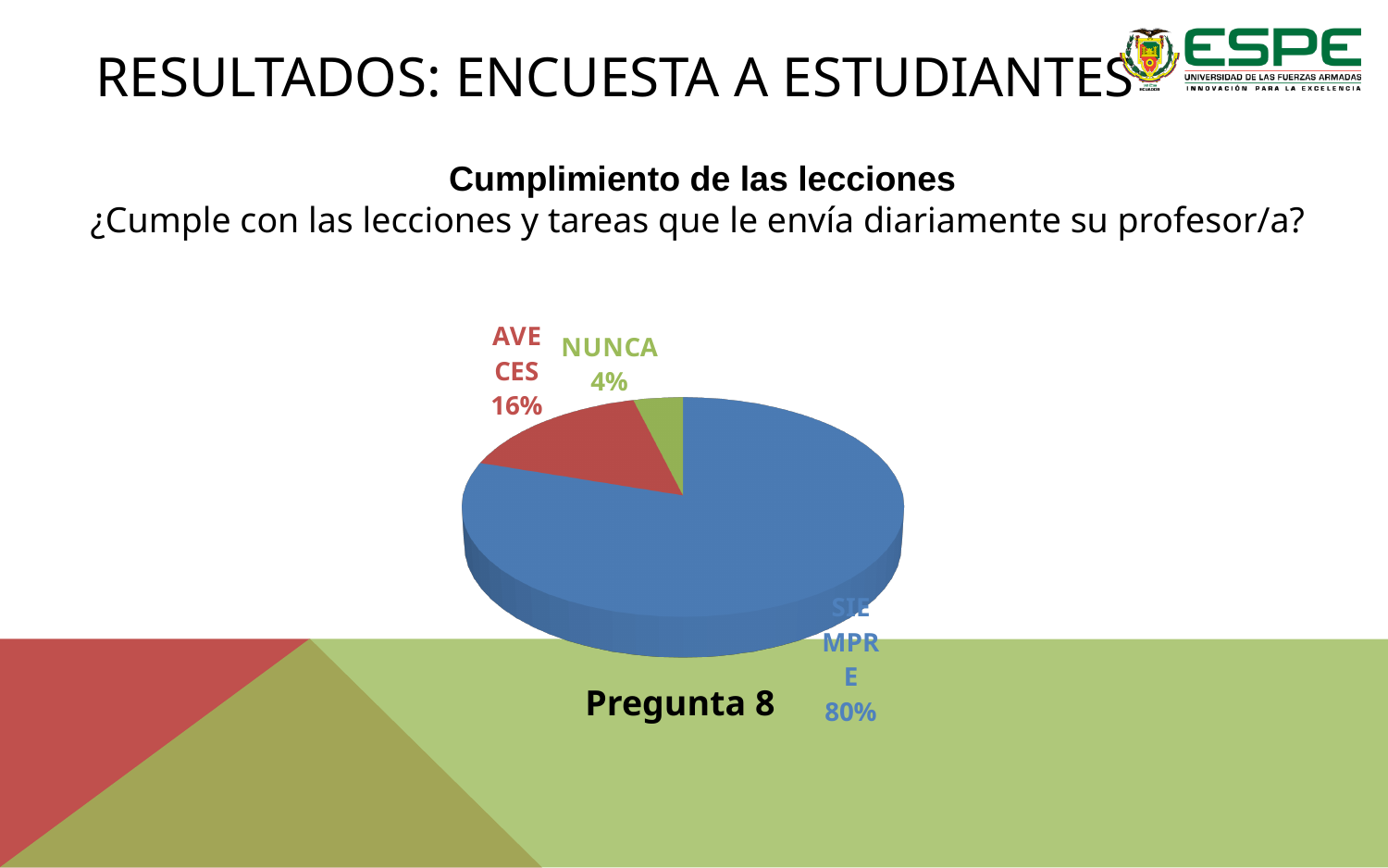
Which is larger, the share for A VECES or the share for NUNCA? A VECES What percentage of students answered SIEMPRE? 80% Which response has the largest share of the pie? SIEMPRE What kind of chart is shown on the slide? pie chart What percentage of students answered NUNCA? 4% What percentage of students answered A VECES? 16% What is the difference in percentage points between SIEMPRE and A VECES? 64 What is the difference in percentage points between A VECES and NUNCA? 12 What colour is the SIEMPRE slice of the pie? blue What is the title shown below the pie chart? Pregunta 8 Which response has the smallest share of the pie? NUNCA How many slices does the pie chart have? 3